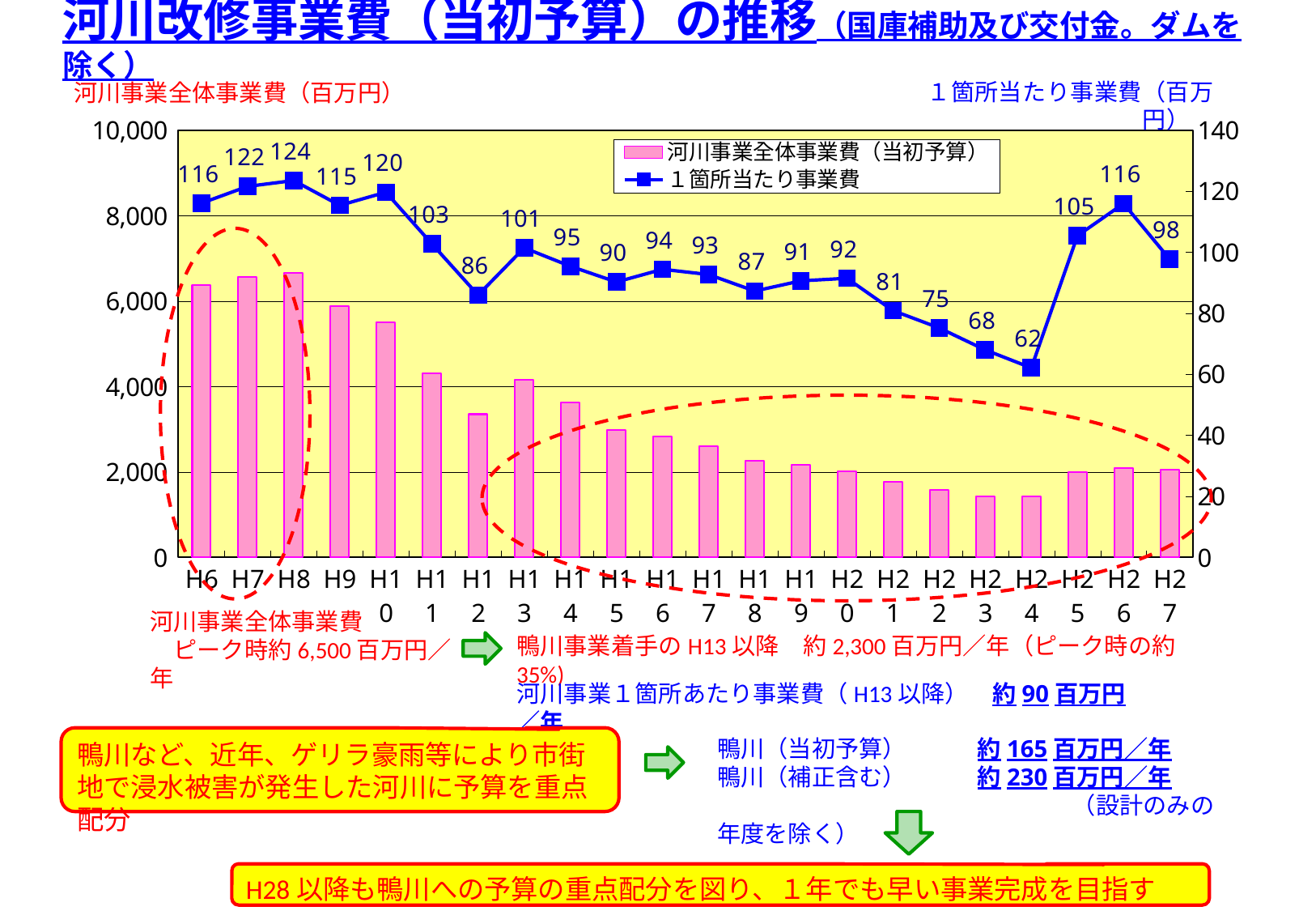
What is the value of １箇所当たり事業費 for H13? 101 How many years are shown on the x axis of the chart? 22 Is the 河川事業全体事業費（当初予算） bar for H8 greater or less than 6,000? greater Which year has the lowest value for １箇所当たり事業費? H24 What is the value of １箇所当たり事業費 for H8? 124 What is the difference between the １箇所当たり事業費 values for H8 and H24? 62 How many series does the chart legend list? 2 Is the 河川事業全体事業費（当初予算） bar for H24 greater or less than 2,000? less Does the １箇所当たり事業費 line rise or fall from H20 to H24? fall Which year has the highest value for １箇所当たり事業費? H8 What is the value of １箇所当たり事業費 for H24? 62 Which year has a larger １箇所当たり事業費 value, H12 or H13? H13